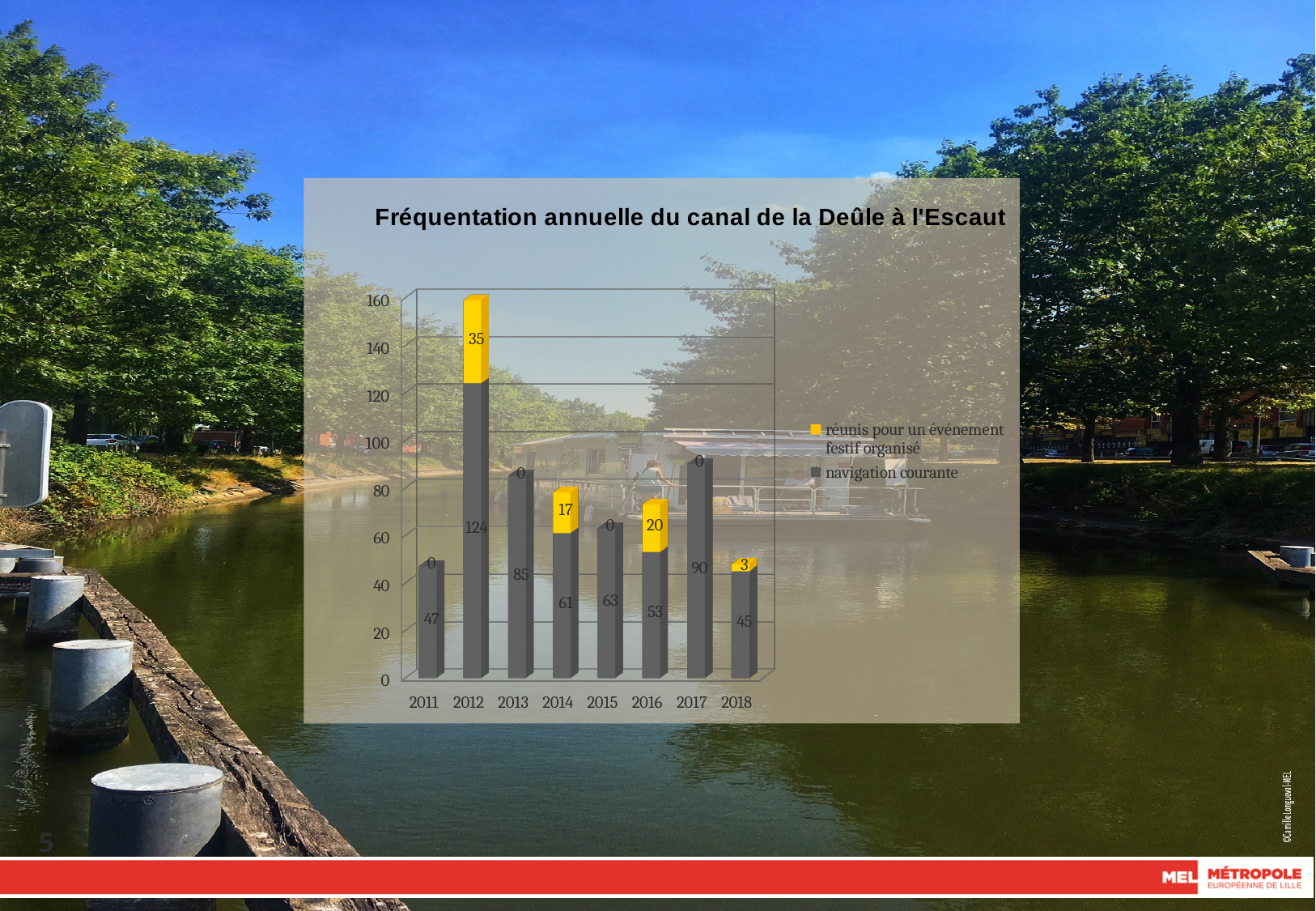
What is the value of réunis pour un événement festif organisé for 2014? 17 Which year has the highest value for navigation courante? 2012 What is the total of the stacked bar for 2016? 73 How many series does the legend list? 2 What is the value of navigation courante for 2018? 45 What is the difference between navigation courante in 2017 and in 2016? 37 How many years are shown on the x axis? 8 What is the value of navigation courante for 2012? 124 Which is larger, navigation courante in 2013 or in 2017? 2017 What is the total of the stacked bar for 2012? 159 What kind of chart is shown on the slide? Stacked bar chart Which year has the lowest value for navigation courante? 2018